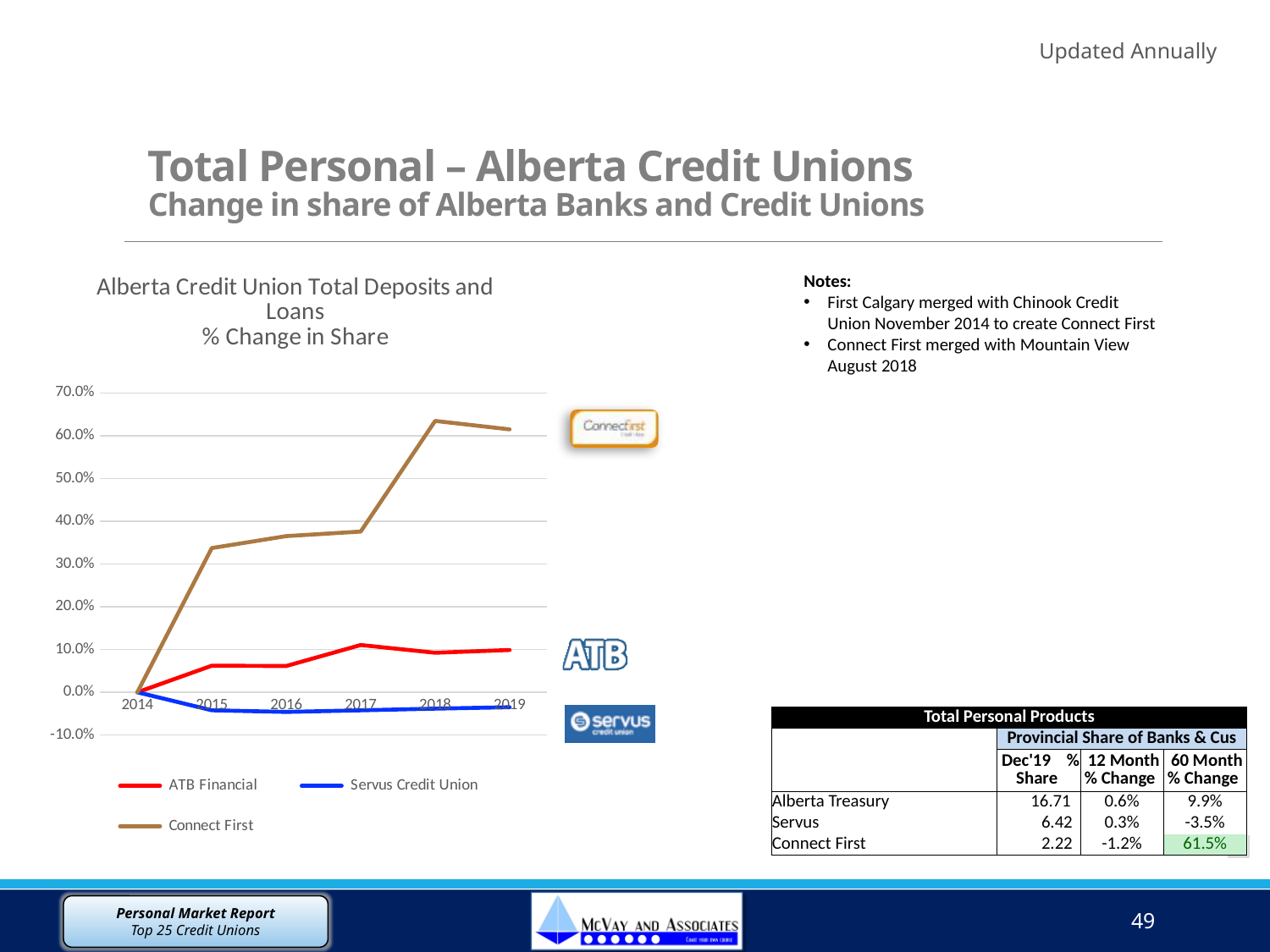
Is the value for Connect First in 2015 greater or less than 30.0%? greater Does the Connect First line generally rise or fall from 2014 to 2018? rise Is the value for Servus Credit Union in 2016 greater or less than 0.0%? less Is the value for Connect First in 2018 greater or less than 60.0%? greater How many series does the chart legend list? 3 How many years are plotted along the x axis of the chart? 6 Which is larger in 2017, the value for ATB Financial or the value for Servus Credit Union? ATB Financial Which series has the highest value in 2019? Connect First What kind of chart is shown on the slide? line chart Which series has the lowest value in 2019? Servus Credit Union What colour is the line for Servus Credit Union? blue